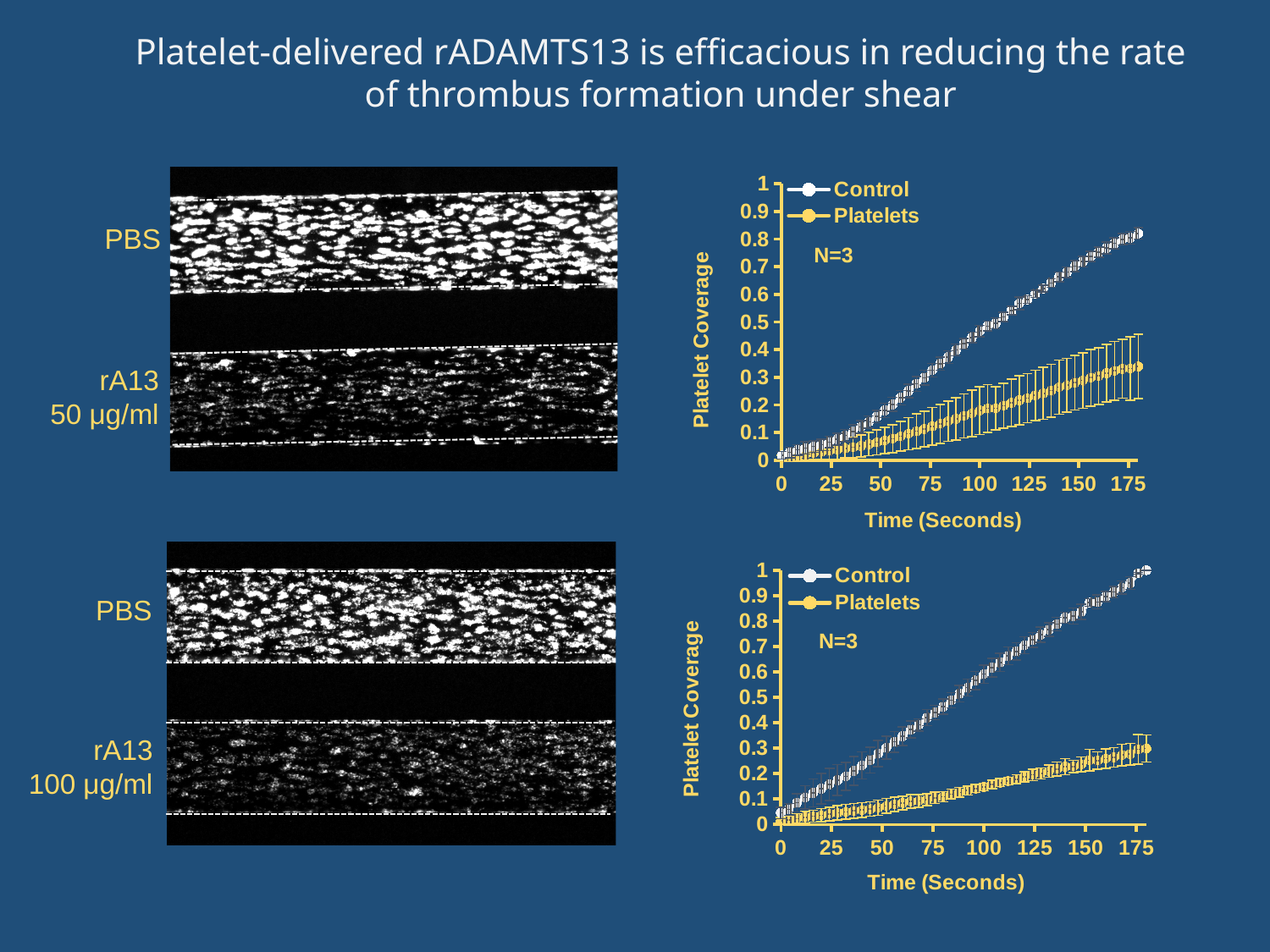
In the bottom-right chart, which series has the higher platelet coverage at 175 seconds, Control or Platelets? Control In the top-right chart, does the Control series rise or fall as time increases? Rise In the bottom-right chart, is the Control value at 175 seconds greater or less than 0.8? greater What kind of chart is the top-right chart on the slide? Line chart How many series does the legend of the top-right chart list? 2 What is the y-axis title of the bottom-right chart? Platelet Coverage In the bottom-right chart, does the Platelets series rise or fall as time increases? Rise In the top-right chart, is the Platelets value at 175 seconds greater or less than 0.5? less In the top-right chart, which series has the higher platelet coverage at 175 seconds, Control or Platelets? Control What is the x-axis title of the bottom-right chart? Time (Seconds) In the bottom-right chart, is the Platelets value at 175 seconds greater or less than 0.5? less